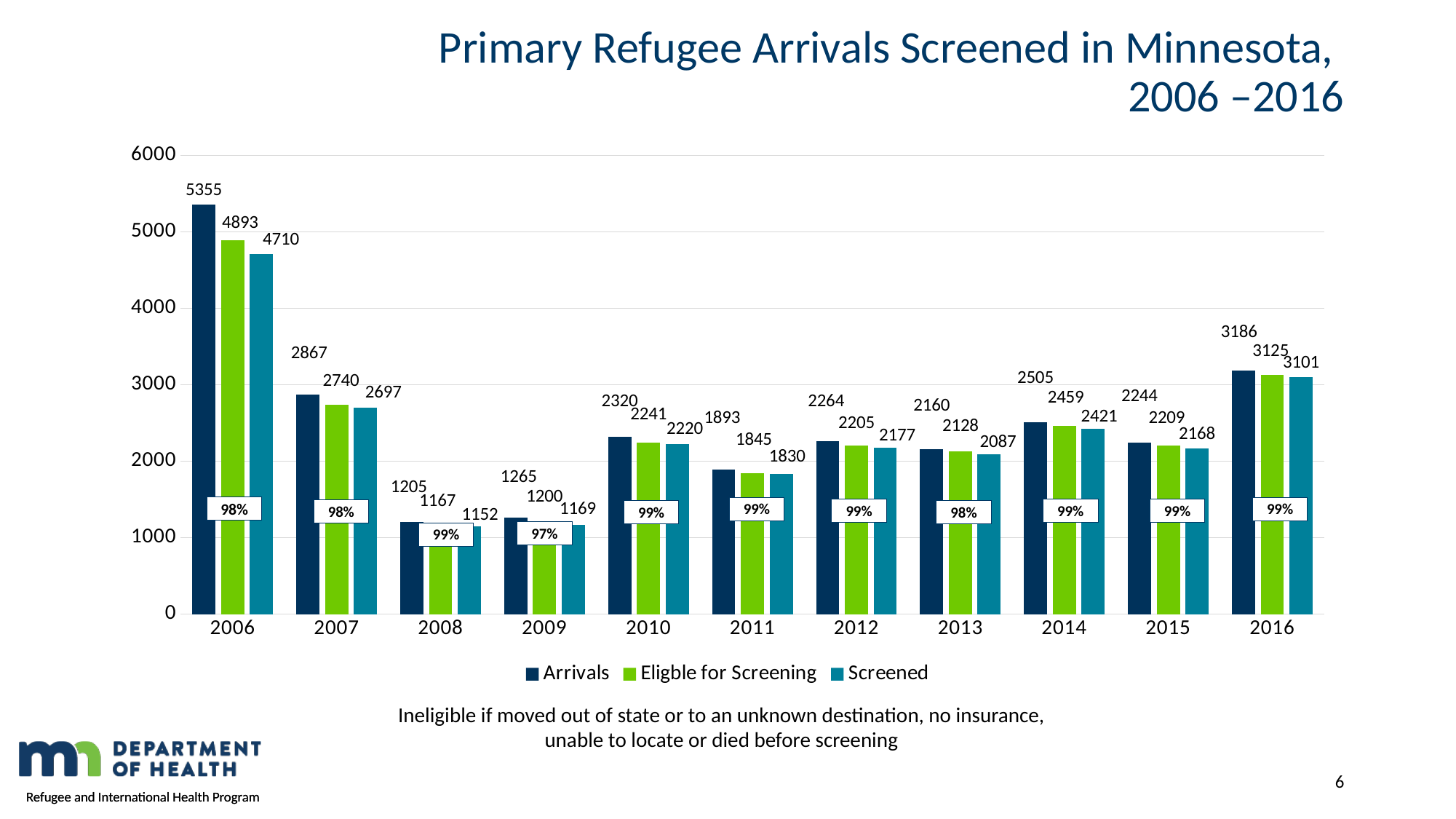
Which year has the lowest Screened value? 2008 Is the value for Arrivals in 2016 greater or less than 3000? greater What is the value for Eligble for Screening in 2012? 2205 What is the value for Screened in 2016? 3101 Which is larger, Arrivals in 2014 or Arrivals in 2015? Arrivals in 2014 Which year has the highest Arrivals value? 2006 What is the difference between Arrivals and Screened in 2007? 170 What percentage label is shown for 2009? 97% How many years are shown on the x axis? 11 What is the value for Arrivals in 2006? 5355 What kind of chart is shown on the slide? bar chart How many series does the legend list? 3